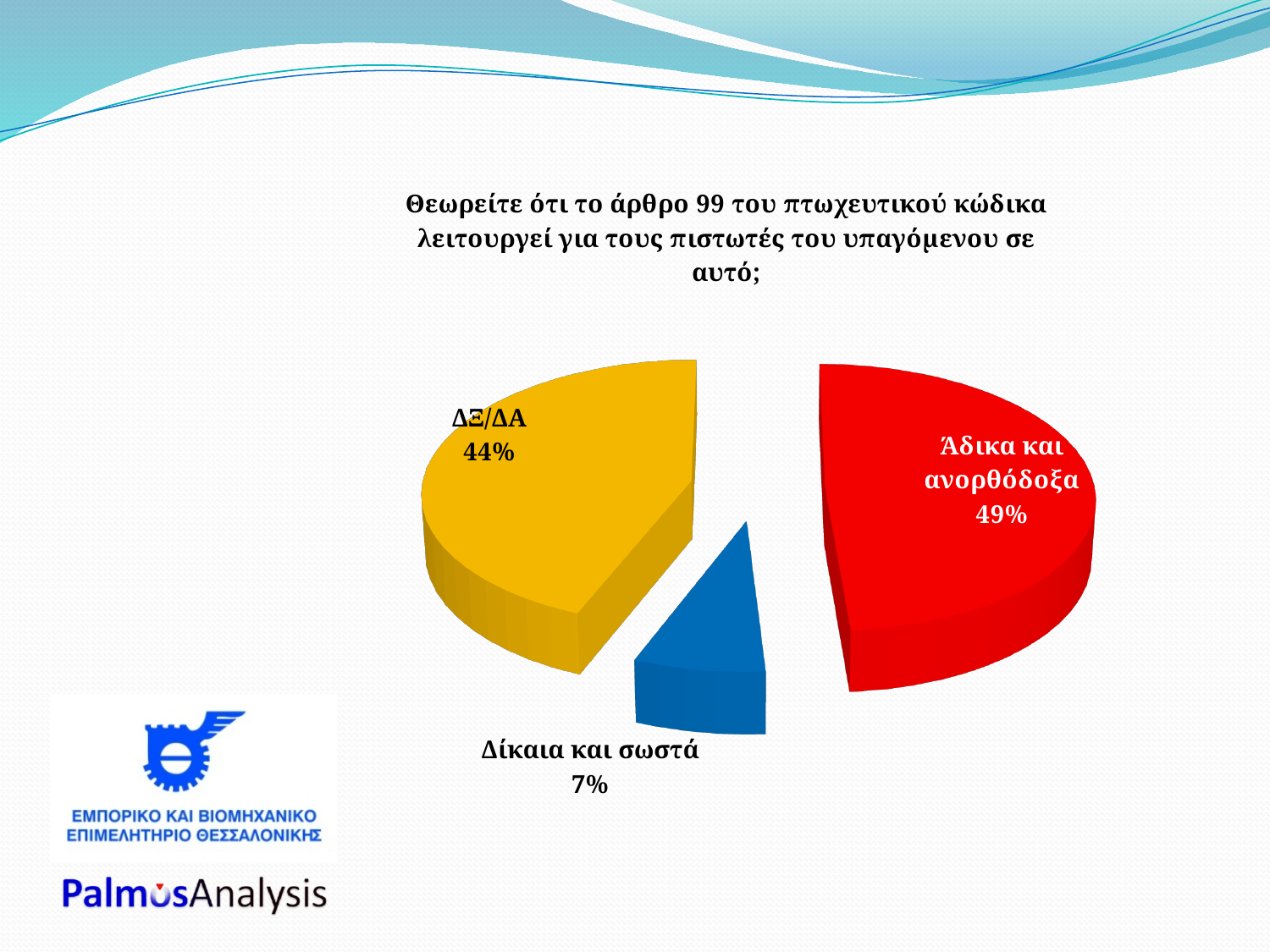
What share of the pie does the slice 'Άδικα και ανορθόδοξα' represent? 49% Which category has the smallest slice of the pie? Δίκαια και σωστά Which is larger, the slice for 'ΔΞ/ΔΑ' or the slice for 'Δίκαια και σωστά'? ΔΞ/ΔΑ What colour is the slice for 'Άδικα και ανορθόδοξα'? Red How many slices does the pie chart have? 3 What kind of chart is shown on the slide? Pie chart What colour is the slice for 'ΔΞ/ΔΑ'? Yellow Which category has the largest slice of the pie? Άδικα και ανορθόδοξα What is the value shown for 'ΔΞ/ΔΑ'? 44% What is the value shown for 'Δίκαια και σωστά'? 7% What is the difference in percentage points between 'Άδικα και ανορθόδοξα' and 'ΔΞ/ΔΑ'? 5 percentage points What is the difference in percentage points between 'ΔΞ/ΔΑ' and 'Δίκαια και σωστά'? 37 percentage points